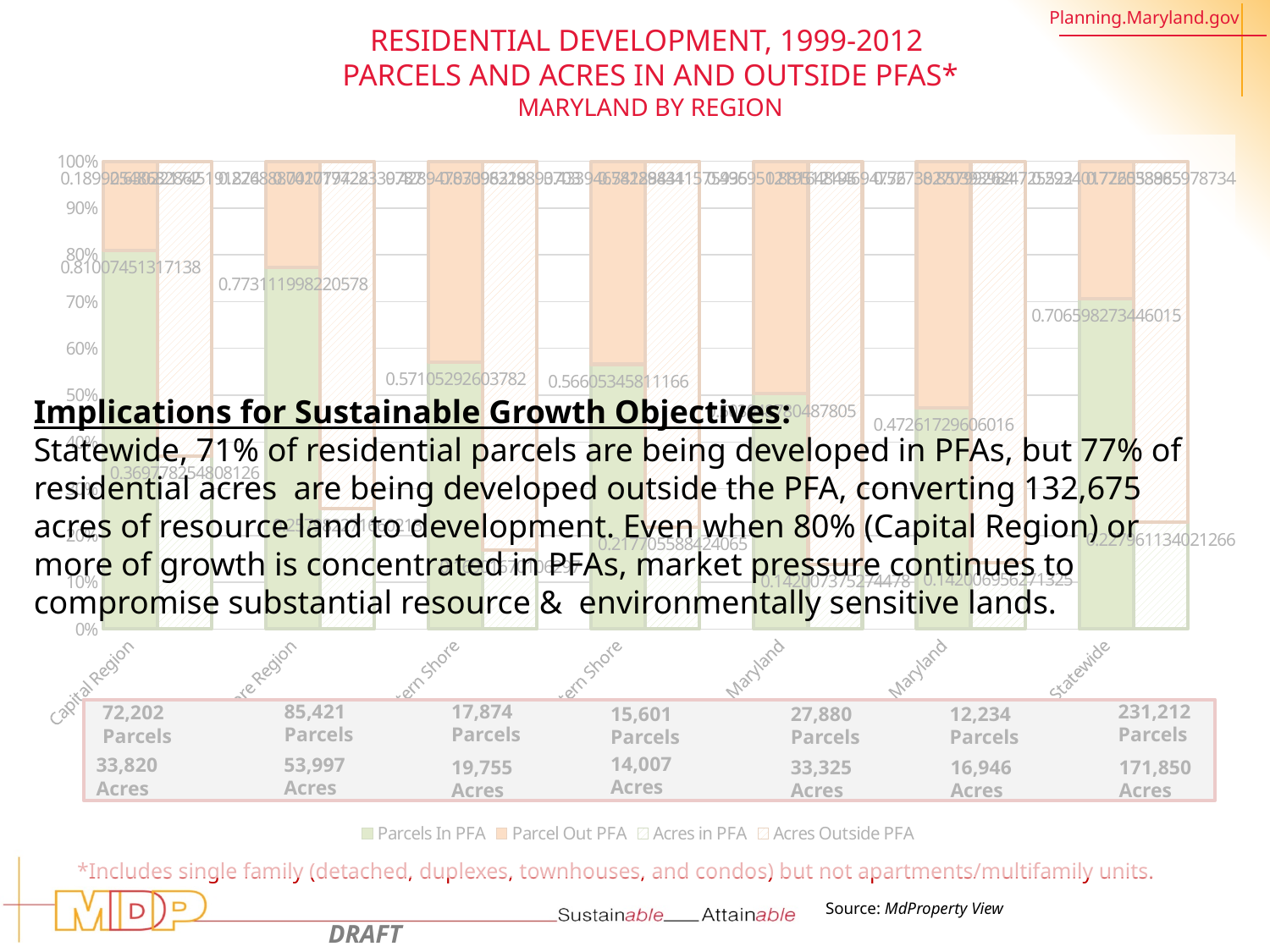
How many series does the chart legend list? 4 What is the Acres in PFA value shown for Statewide? 0.227961134021266 What is the Acres in PFA value shown for the Capital Region? 0.369778254808126 What is the Parcels In PFA value shown for Statewide? 0.706598273446015 Is the Parcels In PFA value for the Capital Region greater or less than 70%? greater How many regions (category groups) are plotted along the x axis of the chart? 7 Is the Acres in PFA value for Statewide greater or less than 30%? less What are the four series listed in the chart legend? Parcels In PFA, Parcel Out PFA, Acres in PFA, Acres Outside PFA Which is larger, the Parcels In PFA share for the Capital Region or for Statewide? Capital Region What is the Parcels In PFA value shown for the Capital Region? 0.81007451317138 What kind of chart is shown on the slide? Stacked bar chart Which region has the highest Parcels In PFA share? Capital Region